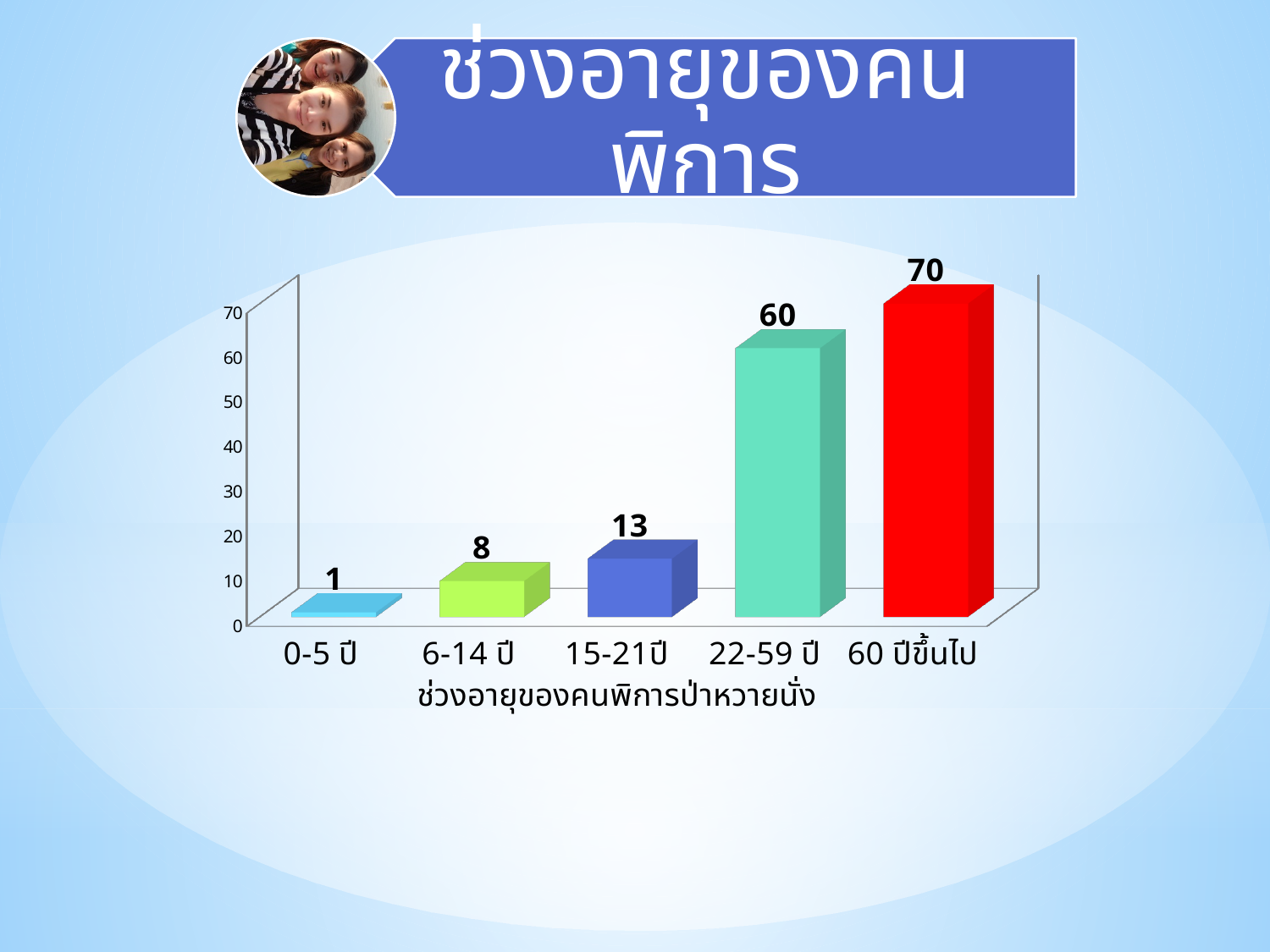
Which age group has the lowest value? 0-5 ปี What kind of chart is shown on the slide? bar chart What is the value for the 15-21ปี category? 13 What is the value for the 0-5 ปี category? 1 Which age group has the highest value? 60 ปีขึ้นไป Do the values rise or fall from left to right along the x axis? rise What is the value for the 6-14 ปี category? 8 What is the difference between the values for 60 ปีขึ้นไป and 22-59 ปี? 10 What is the value for the 60 ปีขึ้นไป category? 70 What is the value for the 22-59 ปี category? 60 How many age group categories are shown on the chart? 5 Which is larger, the value for 6-14 ปี or the value for 15-21ปี? 15-21ปี